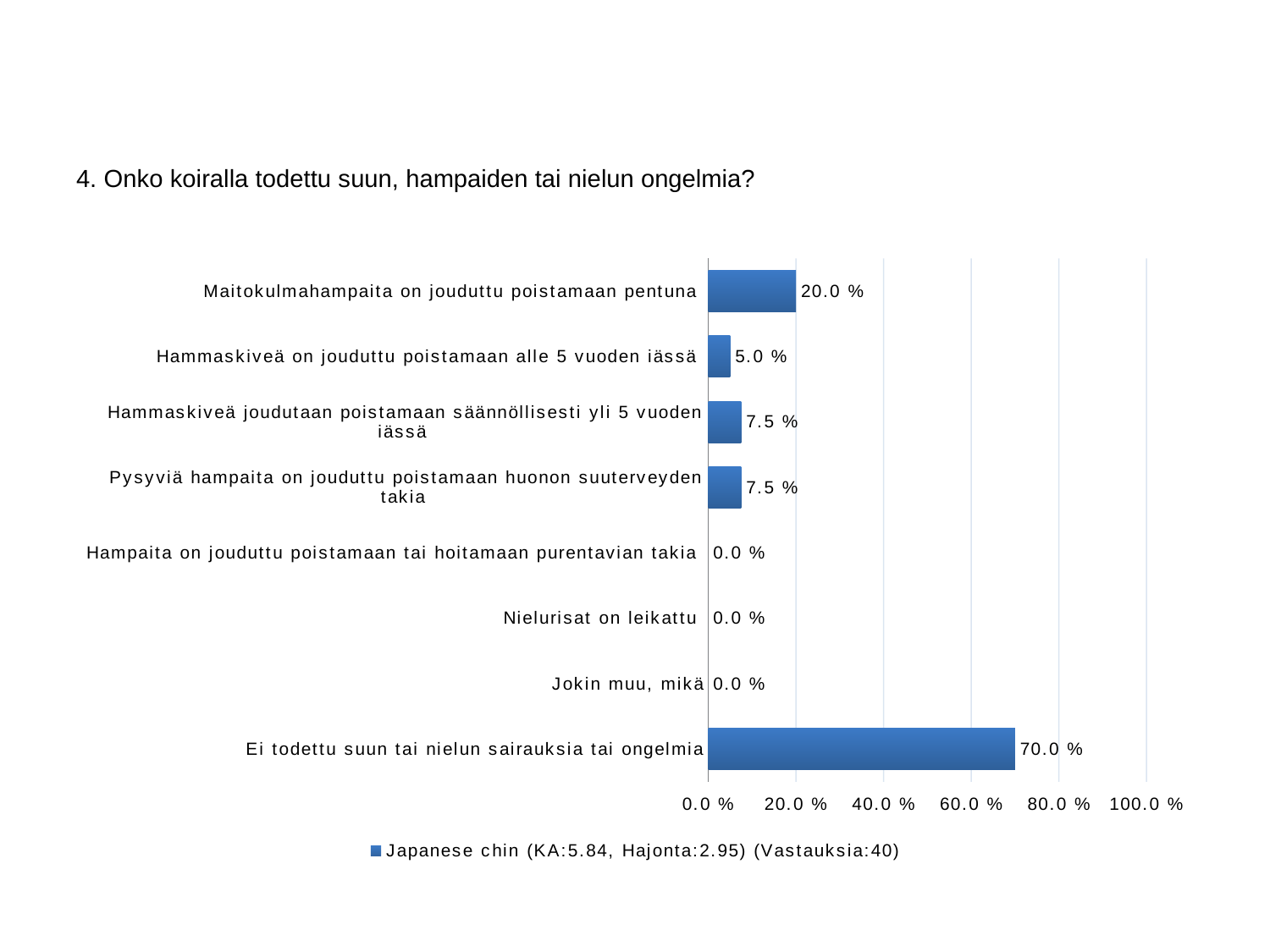
What is the value for "Maitokulmahampaita on jouduttu poistamaan pentuna"? 20.0 % What is the value for "Nielurisat on leikattu"? 0.0 % What is the value for "Hammaskiveä on jouduttu poistamaan alle 5 vuoden iässä"? 5.0 % Which category has the highest value? Ei todettu suun tai nielun sairauksia tai ongelmia What is the difference between the values for "Ei todettu suun tai nielun sairauksia tai ongelmia" and "Maitokulmahampaita on jouduttu poistamaan pentuna"? 50.0 % How many series does the legend list? 1 How many categories are shown in the chart? 8 What is the value for "Ei todettu suun tai nielun sairauksia tai ongelmia"? 70.0 % What kind of chart is shown on the slide? bar chart How many categories have a value of 0.0 %? 3 Is the value for "Ei todettu suun tai nielun sairauksia tai ongelmia" greater or less than 60.0 %? greater Which is larger: the value for "Maitokulmahampaita on jouduttu poistamaan pentuna" or the value for "Hammaskiveä on jouduttu poistamaan alle 5 vuoden iässä"? Maitokulmahampaita on jouduttu poistamaan pentuna